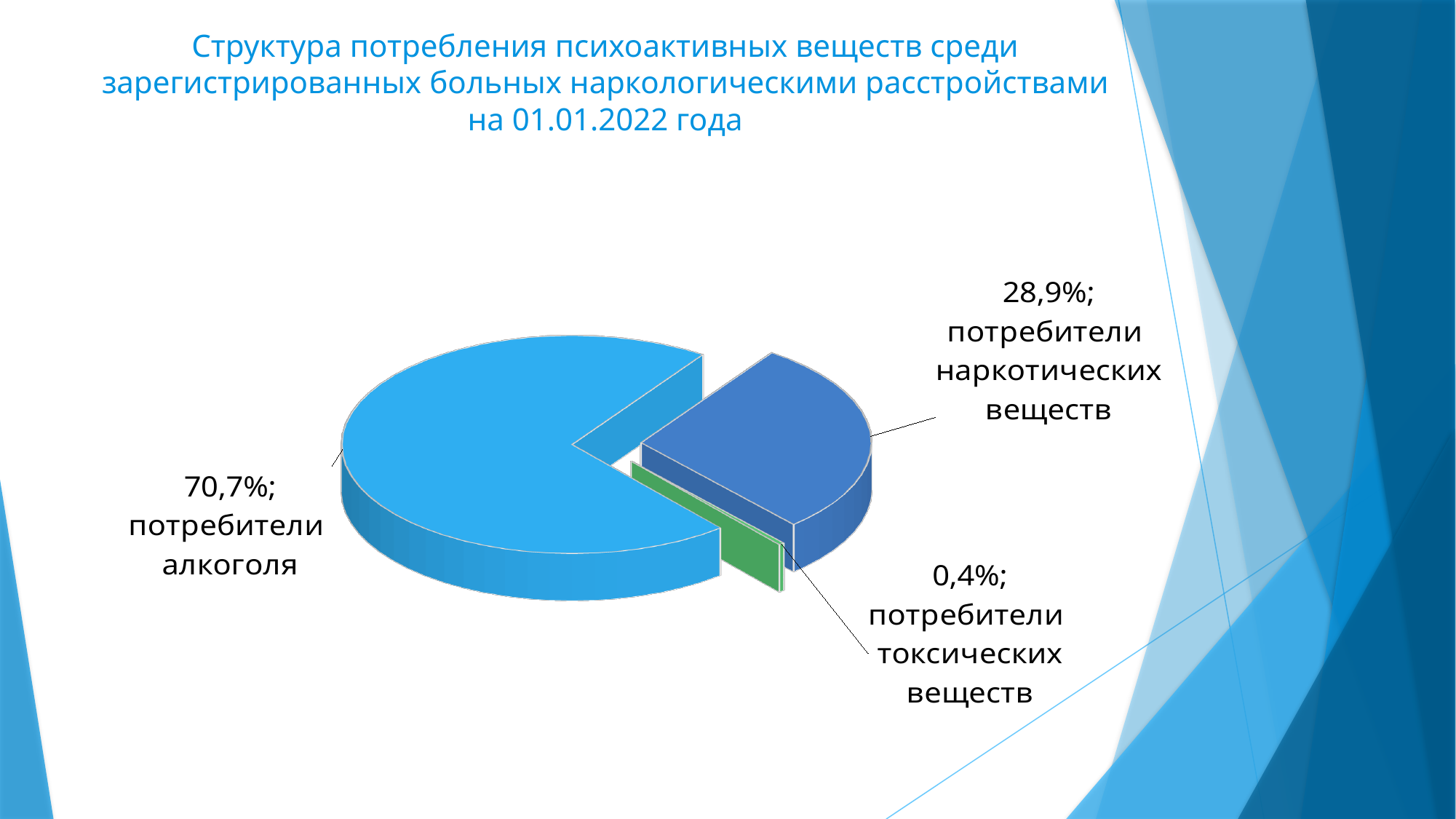
What percentage is shown for "потребители наркотических веществ"? 28,9% How many slices does the pie chart have? 3 What is the difference in percentage points between the share for потребители алкоголя and the share for потребители наркотических веществ? 41,8% What percentage is shown for "потребители токсических веществ"? 0,4% What date is given in the chart title? 01.01.2022 What share of the pie is labelled "потребители алкоголя"? 70,7% Which category has the largest slice of the pie? потребители алкоголя Which category has the smallest slice of the pie? потребители токсических веществ What kind of chart is shown on the slide? pie chart What is the difference in percentage points between the share for потребители наркотических веществ and the share for потребители токсических веществ? 28,5% Which is larger: the share for потребители наркотических веществ or the share for потребители токсических веществ? потребители наркотических веществ What colour is the slice for потребители токсических веществ? green